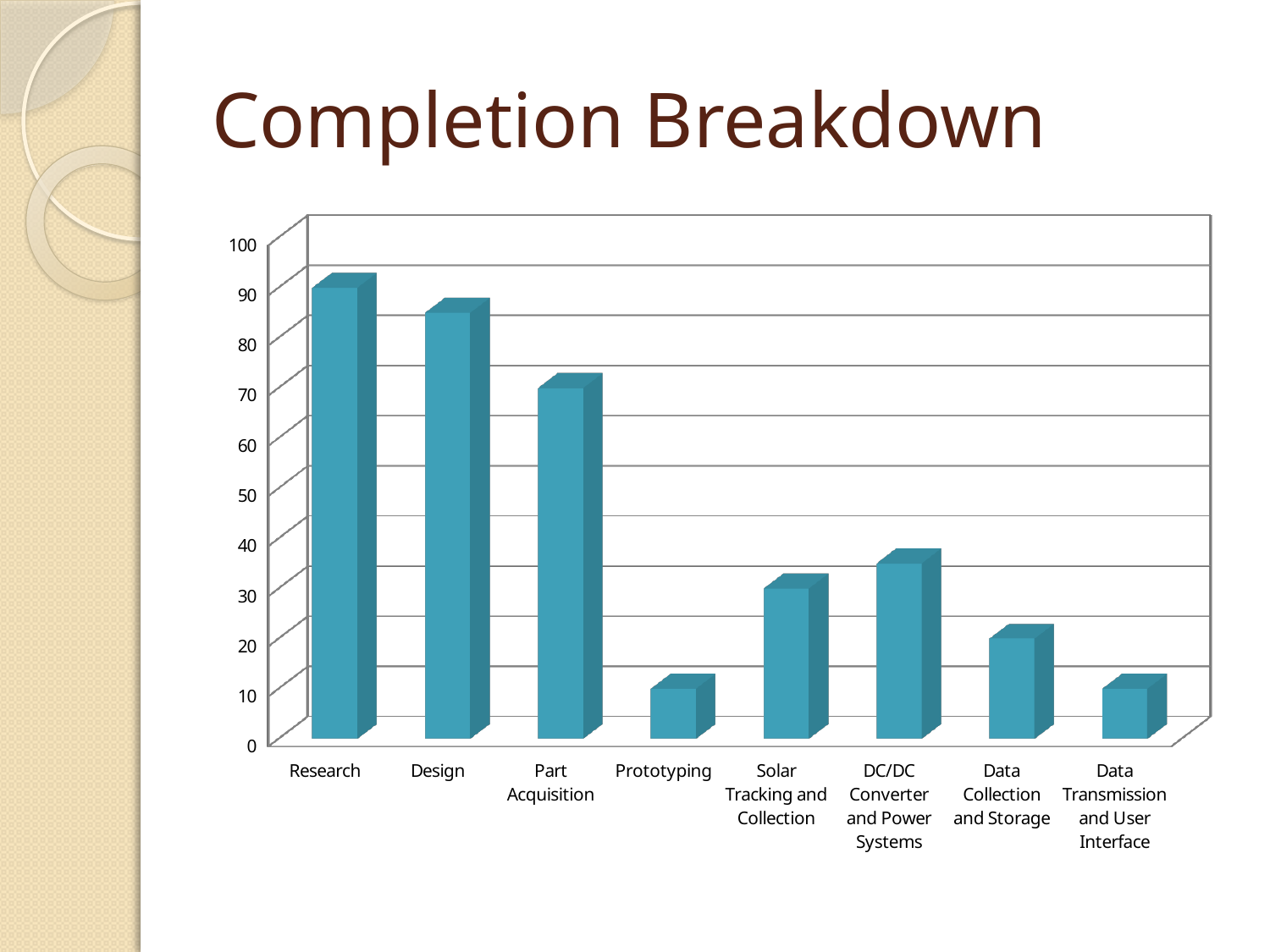
What is the title of the chart? Completion Breakdown Which is larger, the value for DC/DC Converter and Power Systems or the value for Data Collection and Storage? DC/DC Converter and Power Systems What is the value for Part Acquisition? 70 What kind of chart is shown on the slide? bar chart What is the value for Solar Tracking and Collection? 30 Which is larger, the value for Design or the value for Part Acquisition? Design Which category has the highest value? Research Is the value for DC/DC Converter and Power Systems greater or less than 40? less How many categories are plotted in the chart? 8 Is the value for Design greater or less than 80? greater What is the value for Research? 90 Is the value for Prototyping greater or less than 20? less